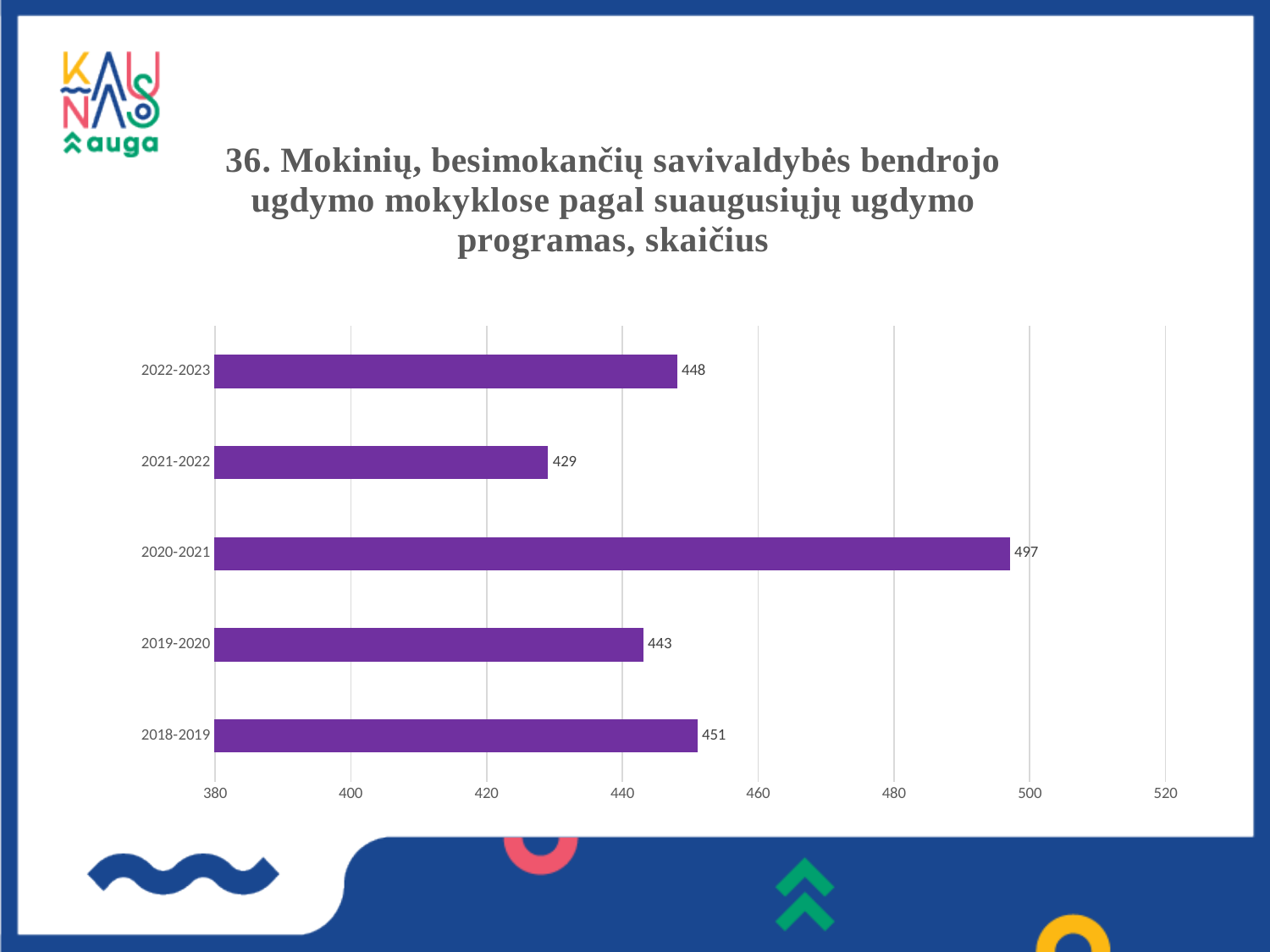
What is the difference between the values for 2020-2021 and 2021-2022? 68 Which is larger, the value for 2018-2019 or the value for 2021-2022? 2018-2019 What is the value shown at the right end of the horizontal axis? 520 What kind of chart is shown on the slide? bar chart What is the value for 2018-2019? 451 Is the value for 2021-2022 greater or less than 440? less What is the difference between the values for 2022-2023 and 2019-2020? 5 How many school years are shown on the chart? 5 Which school year has the highest value? 2020-2021 What is the value for 2022-2023? 448 What is the value for 2020-2021? 497 Which school year has the lowest value? 2021-2022